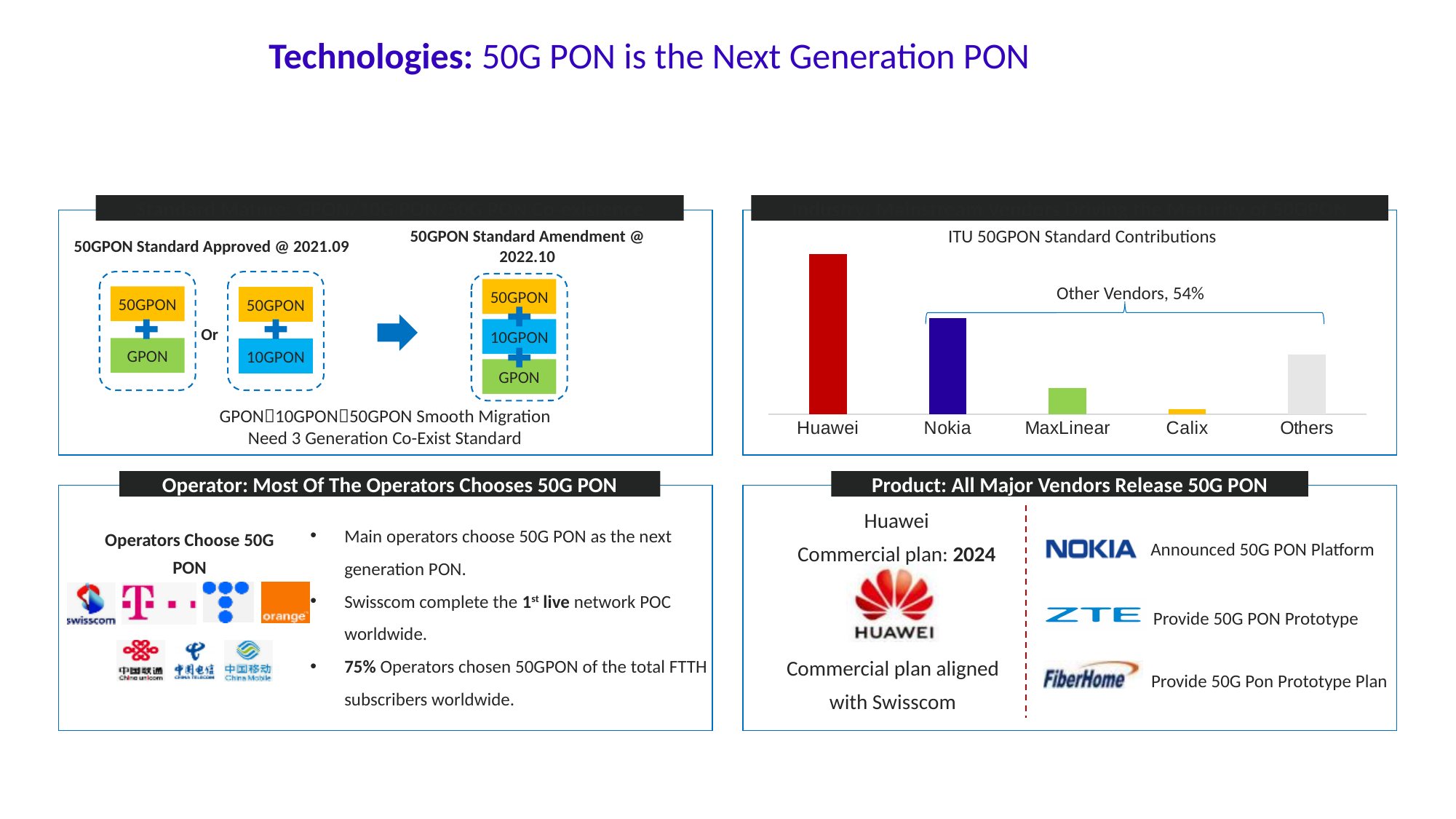
In the ITU 50GPON Standard Contributions chart, which is larger, Others or MaxLinear? Others In the ITU 50GPON Standard Contributions chart, which vendor has the lowest bar? Calix In the ITU 50GPON Standard Contributions chart, which vendor is listed second on the x axis? Nokia In the ITU 50GPON Standard Contributions chart, which is larger, Nokia or Others? Nokia How many categories are shown on the x axis of the ITU 50GPON Standard Contributions chart? 5 In the ITU 50GPON Standard Contributions chart, which vendor has the highest bar? Huawei In the ITU 50GPON Standard Contributions chart, which is larger, MaxLinear or Calix? MaxLinear What kind of chart is the ITU 50GPON Standard Contributions chart? bar chart What is the title of the bar chart on the slide? ITU 50GPON Standard Contributions What percentage is labelled for Other Vendors in the ITU 50GPON Standard Contributions chart? 54%